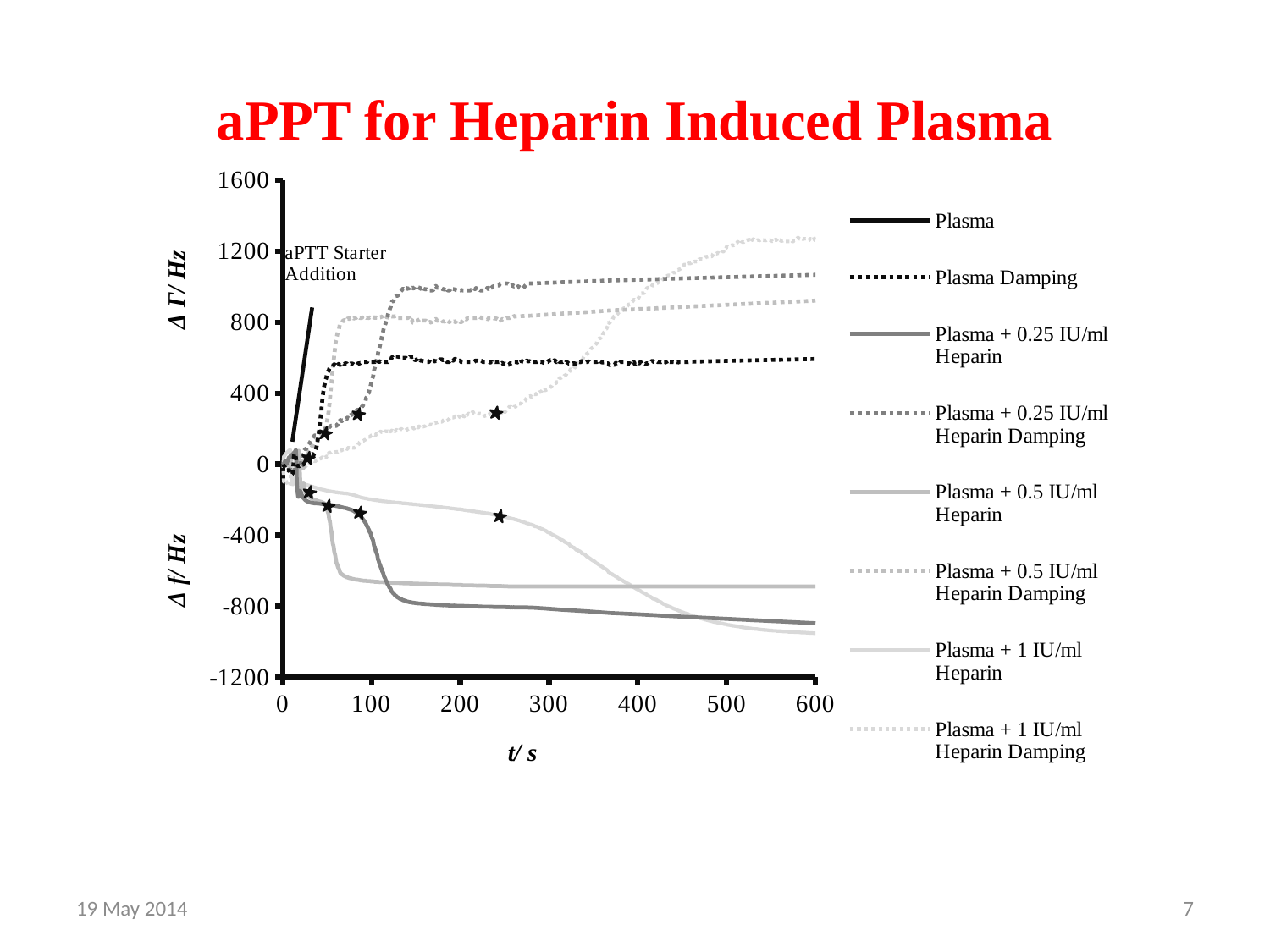
At t = 600 s, which series has the higher value: Plasma Damping or Plasma + 1 IU/ml Heparin Damping? Plasma + 1 IU/ml Heparin Damping What is the label on the x axis of the chart? t/ s Does the Plasma + 0.25 IU/ml Heparin series rise or fall as t increases from 0 to 600 s? fall Which series reaches the highest value on the chart at t = 600 s? Plasma + 1 IU/ml Heparin Damping Is the value of the Plasma + 1 IU/ml Heparin Damping series at t = 600 s greater or less than 800? greater What is the title of the chart on the slide? aPPT for Heparin Induced Plasma How many series does the legend list? 8 Is the value of the Plasma Damping series at t = 600 s greater or less than 400? greater Does the Plasma + 0.25 IU/ml Heparin Damping series rise or fall as t increases from 0 to 600 s? rise Is the value of the Plasma + 0.25 IU/ml Heparin series at t = 600 s greater or less than -800? less What kind of chart is shown on the slide? Line chart